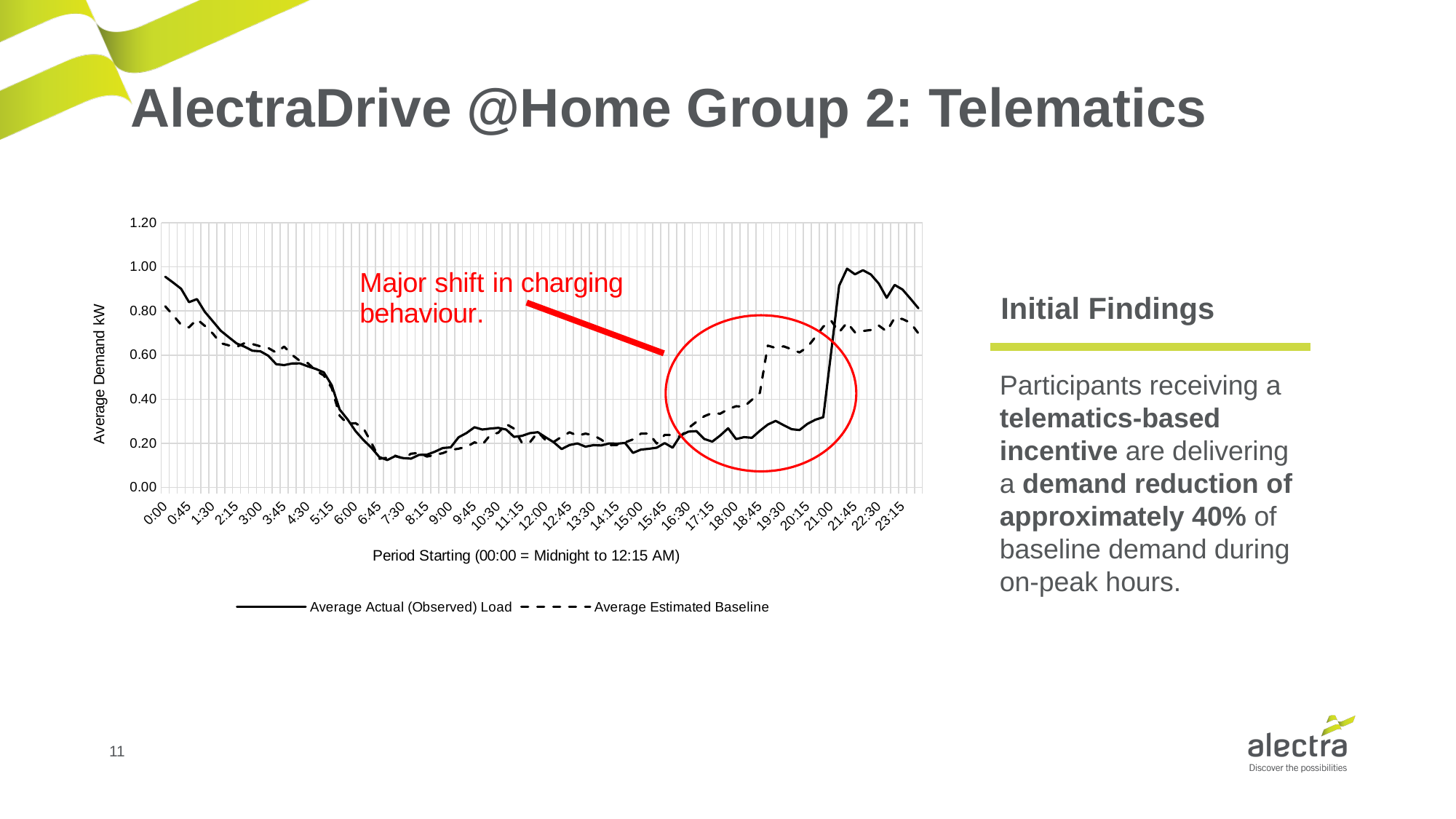
Which series is drawn with a dashed line in the chart? Average Estimated Baseline How many series does the chart's legend list? 2 At 19:30, which series has the higher value: Average Actual (Observed) Load or Average Estimated Baseline? Average Estimated Baseline Which series reaches the highest value anywhere on the chart? Average Actual (Observed) Load Does the Average Actual (Observed) Load rise or fall between 0:00 and 6:45? fall Is the Average Estimated Baseline at 19:30 greater or less than 0.40? greater Is the Average Actual (Observed) Load at 6:45 greater or less than 0.20? less Is the Average Actual (Observed) Load at 19:30 greater or less than 0.40? less What kind of chart is shown on the slide? Line chart What is the title of the chart's vertical axis? Average Demand kW At 21:45, which series has the higher value: Average Actual (Observed) Load or Average Estimated Baseline? Average Actual (Observed) Load